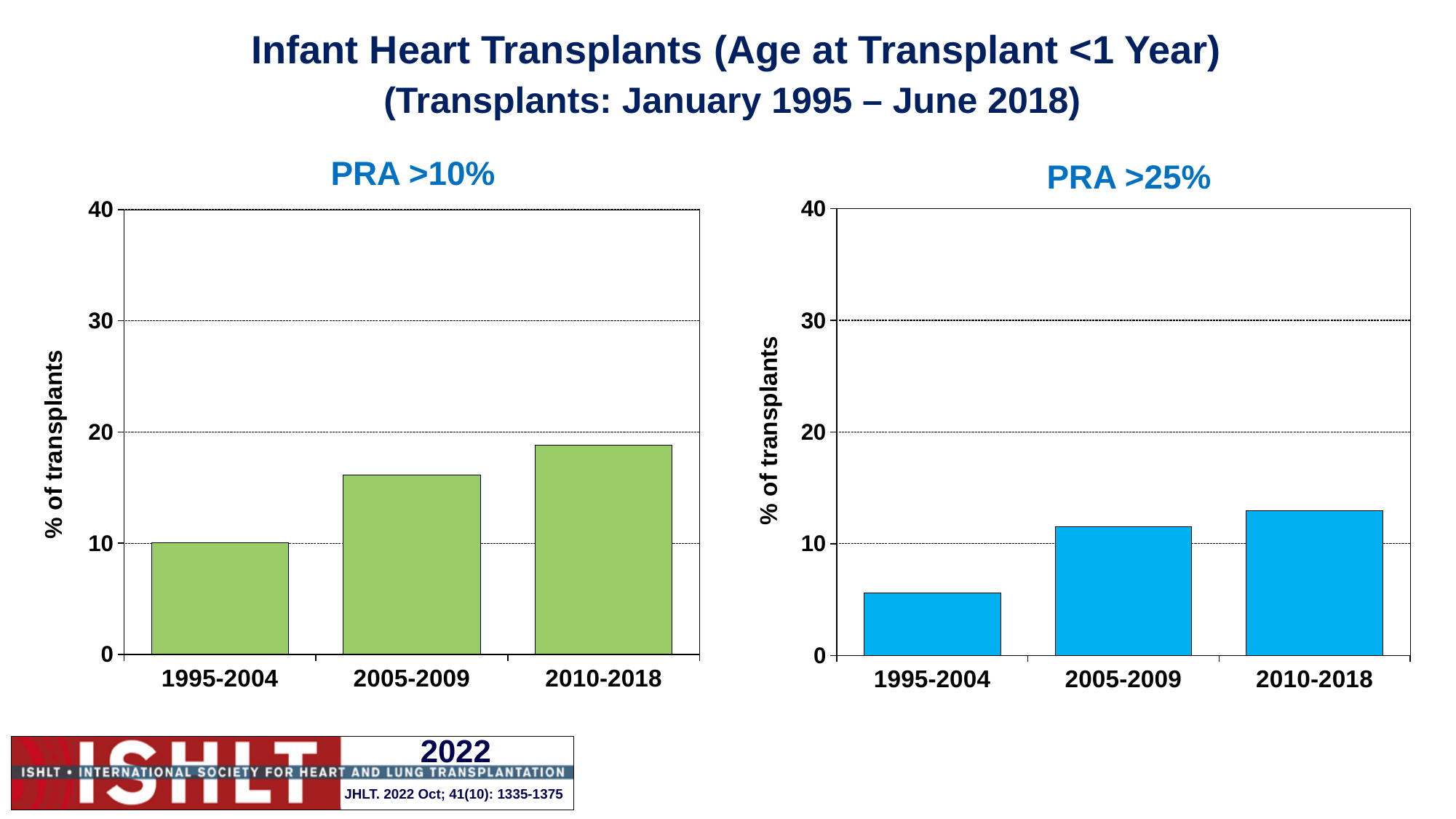
What colour are the bars on the PRA >25% chart? blue On the PRA >10% chart, is the value for 2010-2018 greater or less than 30? less On the PRA >25% chart, is the value for 2010-2018 greater or less than 10? greater On the PRA >10% chart, is the value for 2005-2009 greater or less than 10? greater On the PRA >25% chart, which is larger: the value for 1995-2004 or the value for 2005-2009? 2005-2009 On the PRA >10% chart, which period has the highest percentage of transplants? 2010-2018 What kind of chart is the PRA >10% chart on the left? bar chart On the PRA >25% chart, which period has the lowest percentage of transplants? 1995-2004 On the PRA >10% chart, do the values rise or fall from 1995-2004 to 2010-2018? rise What is the y-axis label on the PRA >10% chart? % of transplants How many time-period categories are shown on the PRA >25% chart? 3